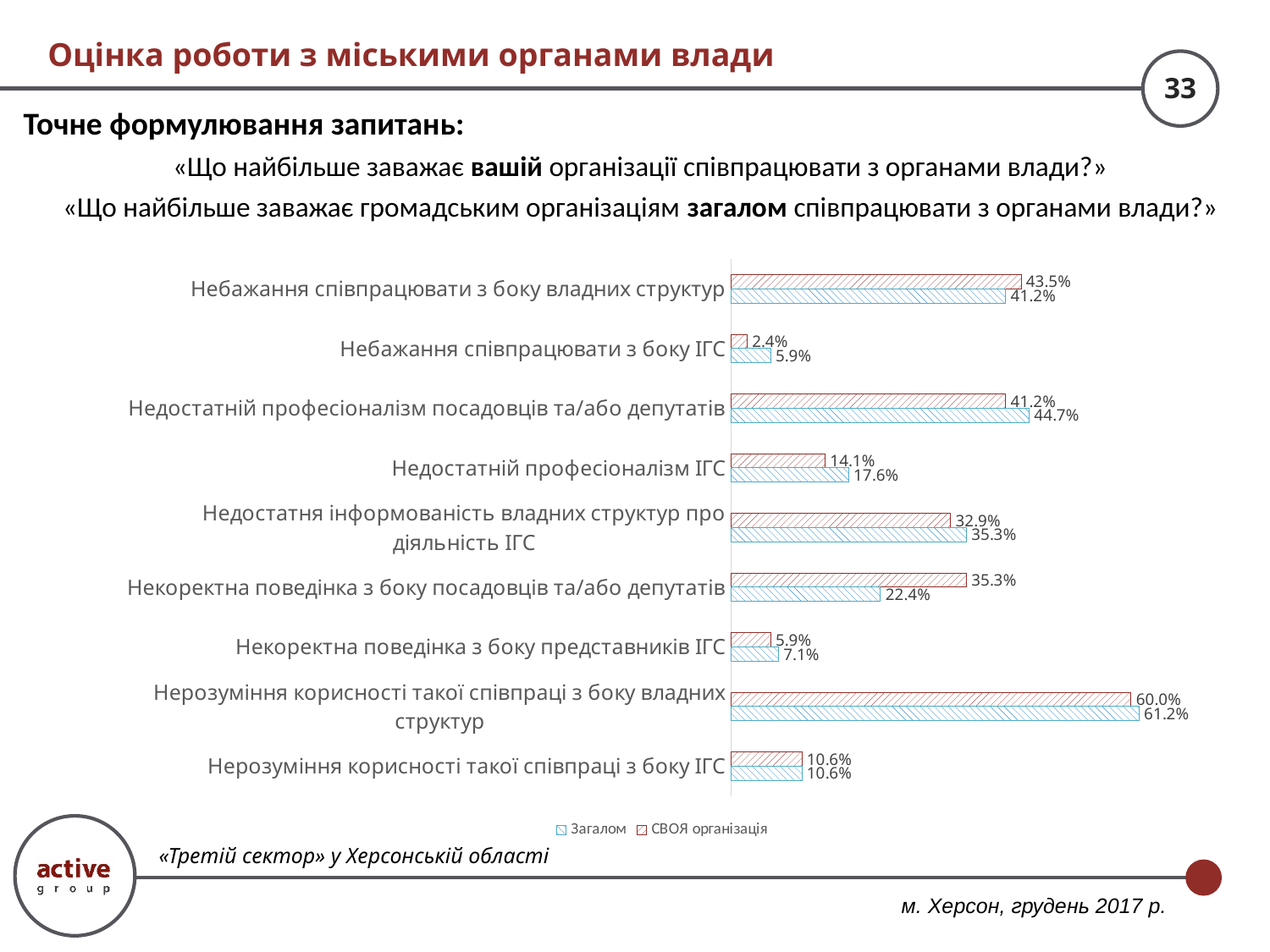
What is the value for "Загалом" for "Некоректна поведінка з боку посадовців та/або депутатів"? 22.4% For "Небажання співпрацювати з боку ІГС", which series has the larger value, "Загалом" or "СВОЯ організація"? Загалом Which category has the highest value for the "Загалом" series? Нерозуміння корисності такої співпраці з боку владних структур How many categories are shown on the chart? 9 What are the two series listed in the chart legend? Загалом and СВОЯ організація What is the value for "СВОЯ організація" for "Нерозуміння корисності такої співпраці з боку ІГС"? 10.6% What is the difference between the "СВОЯ організація" and "Загалом" values for "Некоректна поведінка з боку посадовців та/або депутатів"? 12.9% What is the value for "СВОЯ організація" for "Небажання співпрацювати з боку владних структур"? 43.5% How many series does the legend list? 2 Which category has the lowest value for the "СВОЯ організація" series? Небажання співпрацювати з боку ІГС What kind of chart is shown on the slide? Bar chart What is the value for "Загалом" for "Недостатній професіоналізм посадовців та/або депутатів"? 44.7%